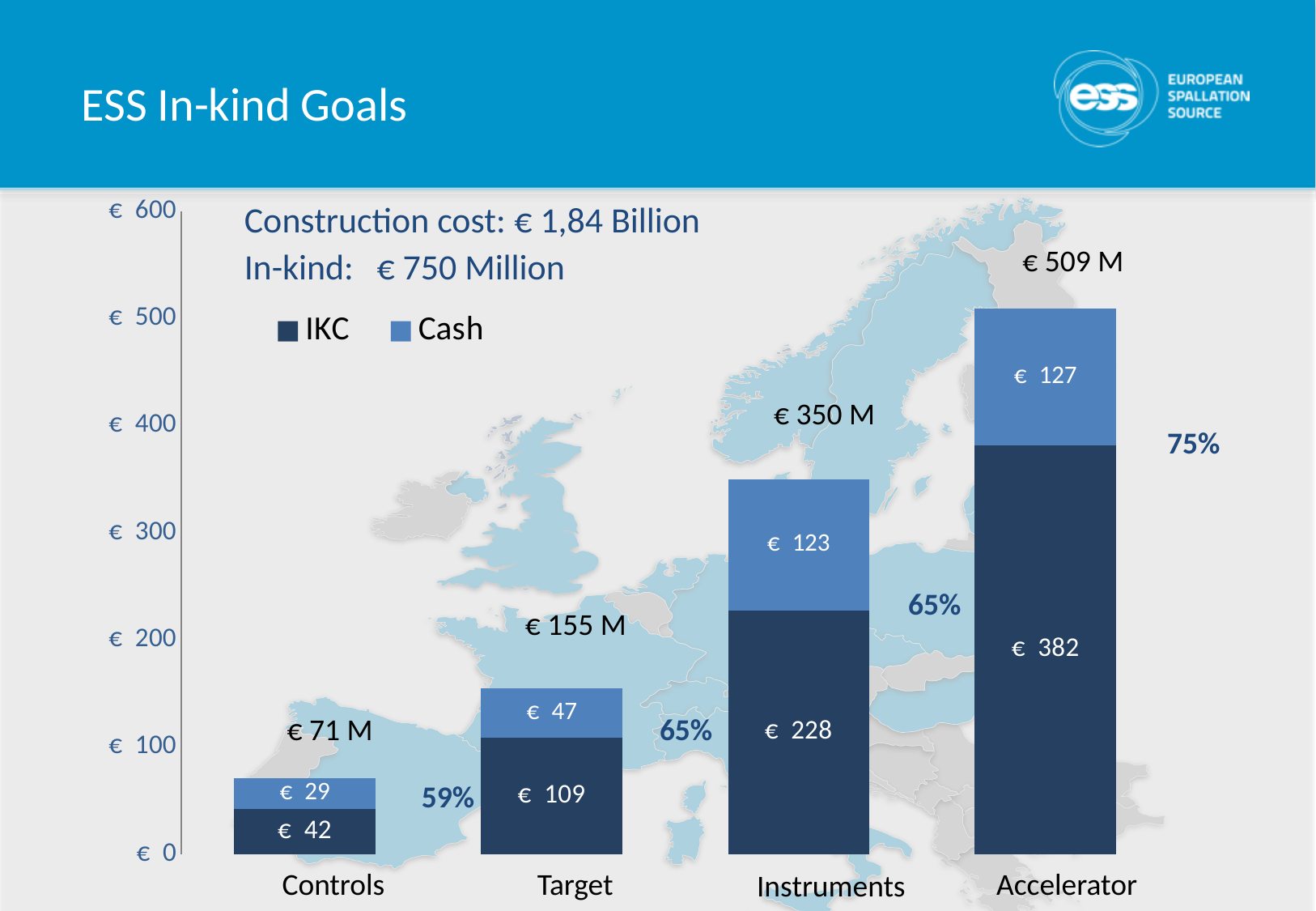
What is the IKC value for Accelerator? € 382 Which category has the highest total? Accelerator What percentage is shown next to the Accelerator bar? 75% How many categories are shown on the x axis? 4 What is the total shown above the Instruments bar? € 350 M What is the Cash value for Target? € 47 Which is larger, the Cash value for Accelerator or the Cash value for Instruments? Accelerator Do the bar totals rise or fall from Controls to Accelerator? Rise Which category has the lowest IKC value? Controls What kind of chart is shown on the slide? Stacked bar chart What is the difference between the IKC values for Instruments and Target? € 119 How many series does the legend list? 2